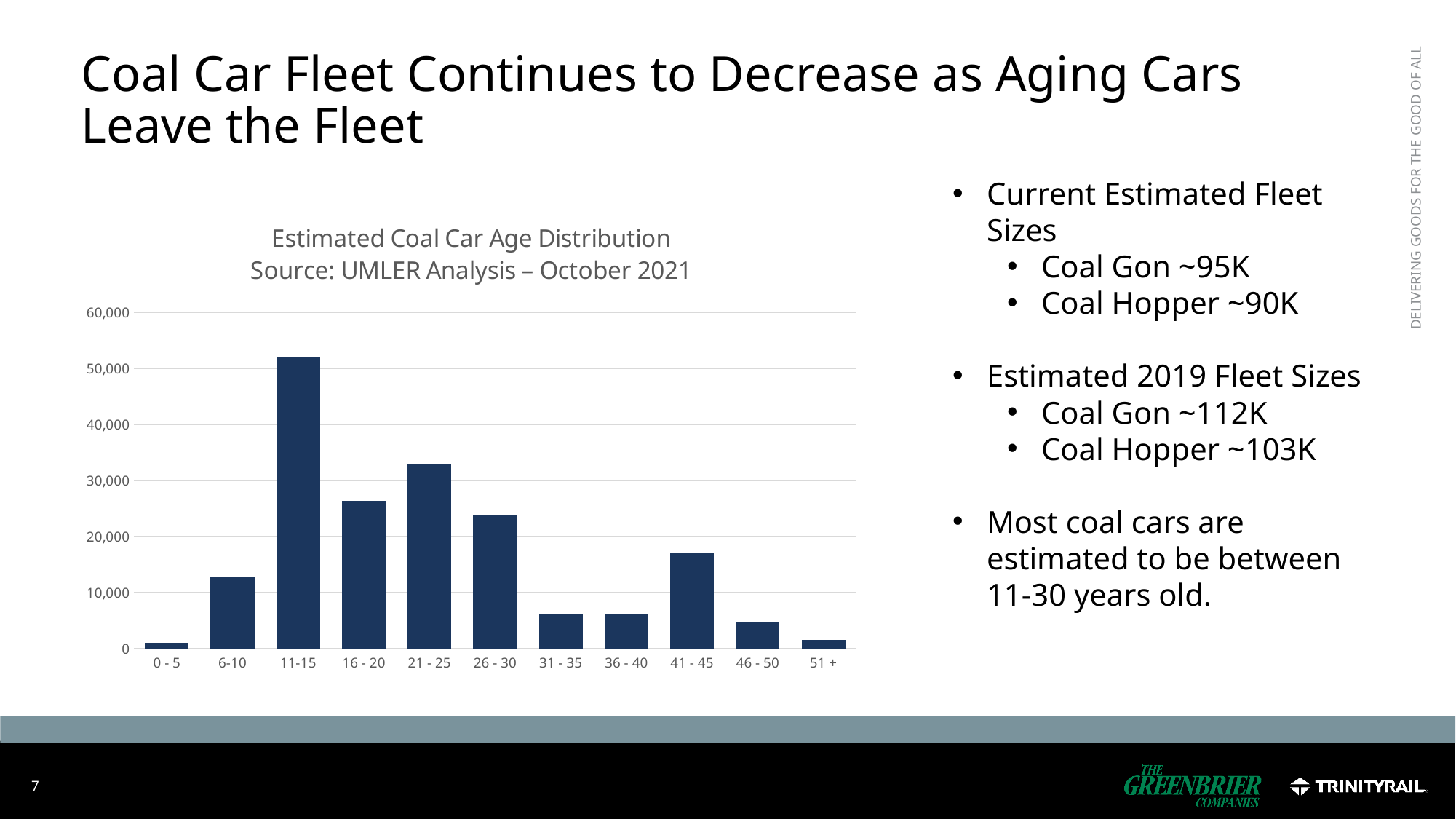
Is the value for the 6-10 age category greater or less than 10,000? greater What kind of chart is shown on the slide? Bar chart Which has the larger value, the 26 - 30 category or the 41 - 45 category? 26 - 30 What source is cited under the chart title? UMLER Analysis – October 2021 Is the value for the 11-15 age category greater or less than 40,000? greater What is the title of the chart? Estimated Coal Car Age Distribution Which age category has the highest bar in the chart? 11-15 Which has the larger value, the 21 - 25 category or the 16 - 20 category? 21 - 25 How many age categories are shown on the x axis of the chart? 11 Is the value for the 21 - 25 age category greater or less than 30,000? greater